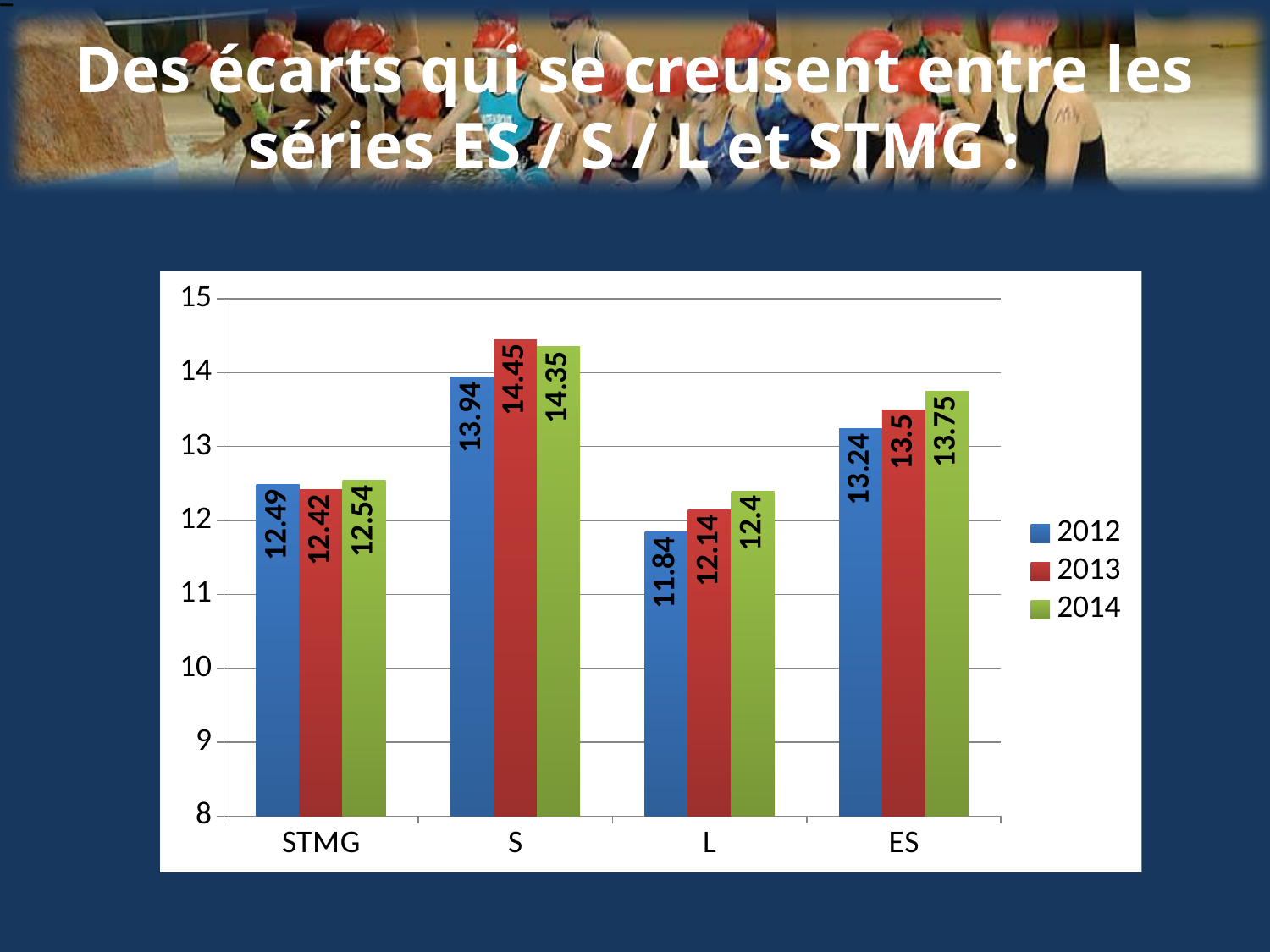
Which category has the lowest value in 2012? L What is the value for STMG in 2013? 12.42 What is the difference between the 2014 and 2012 values for L? 0.56 What is the value for ES in 2014? 13.75 What is the value for S in 2013? 14.45 Which is larger: the 2014 value for ES or the 2014 value for STMG? ES How many categories are shown on the x axis? 4 What is the value for L in 2012? 11.84 What kind of chart is shown on the slide? Bar chart How many series does the legend list? 3 Which colour represents the 2013 series in the legend? Red Which category has the highest value in 2014? S